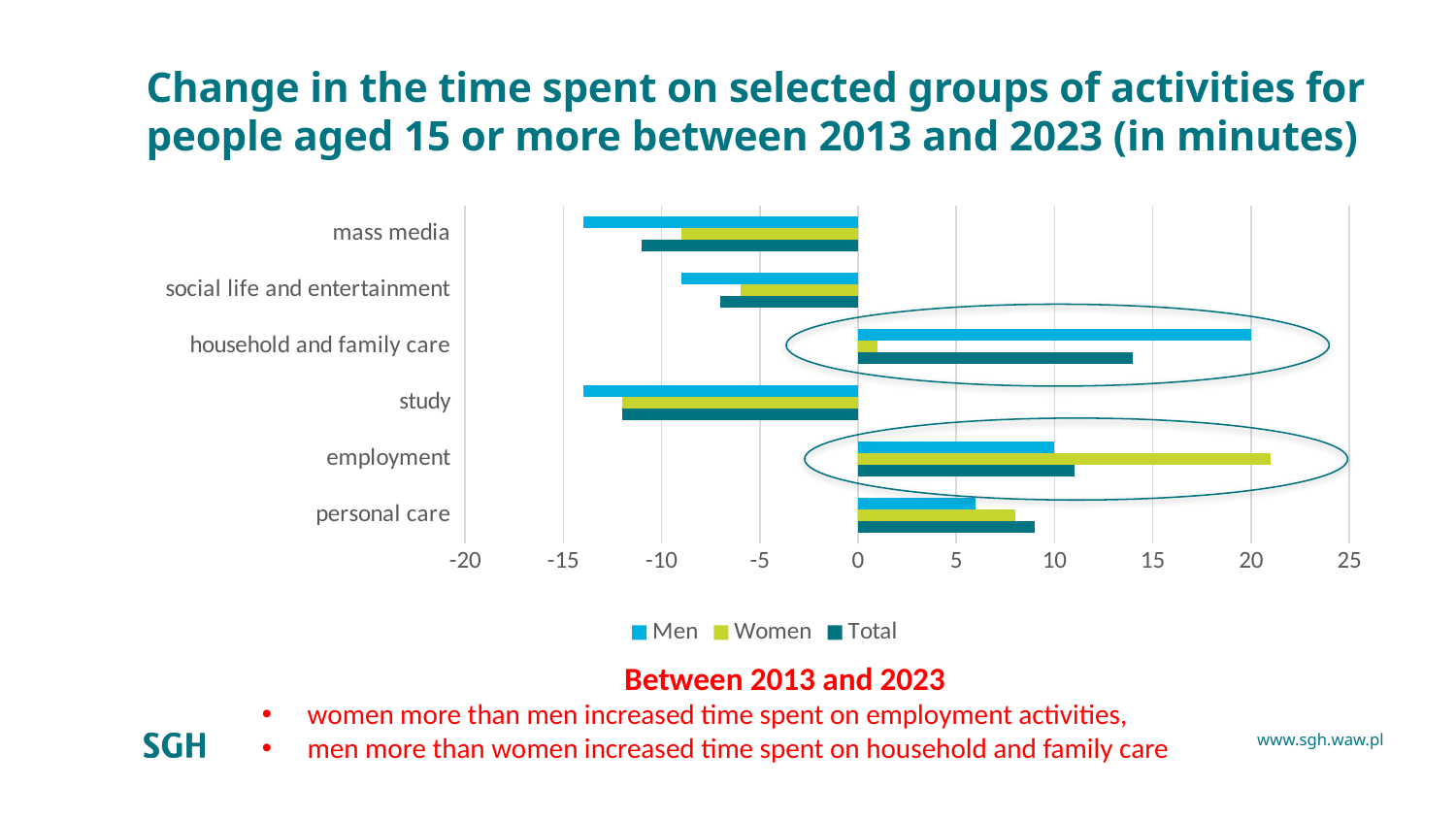
Which activity group has the highest Men value? household and family care Which activity group has the highest Women value? employment How many series does the legend list? 3 Is the Men value for household and family care greater or less than 15? greater How many activity groups (categories) are plotted on the chart? 6 For employment, which is larger: the Women value or the Men value? Women For household and family care, which is larger: the Men value or the Women value? Men What are the three series named in the legend? Men, Women, Total What kind of chart is shown on the slide? bar chart Is the Total value for mass media greater or less than -5? less Is the Men value for study greater or less than -10? less